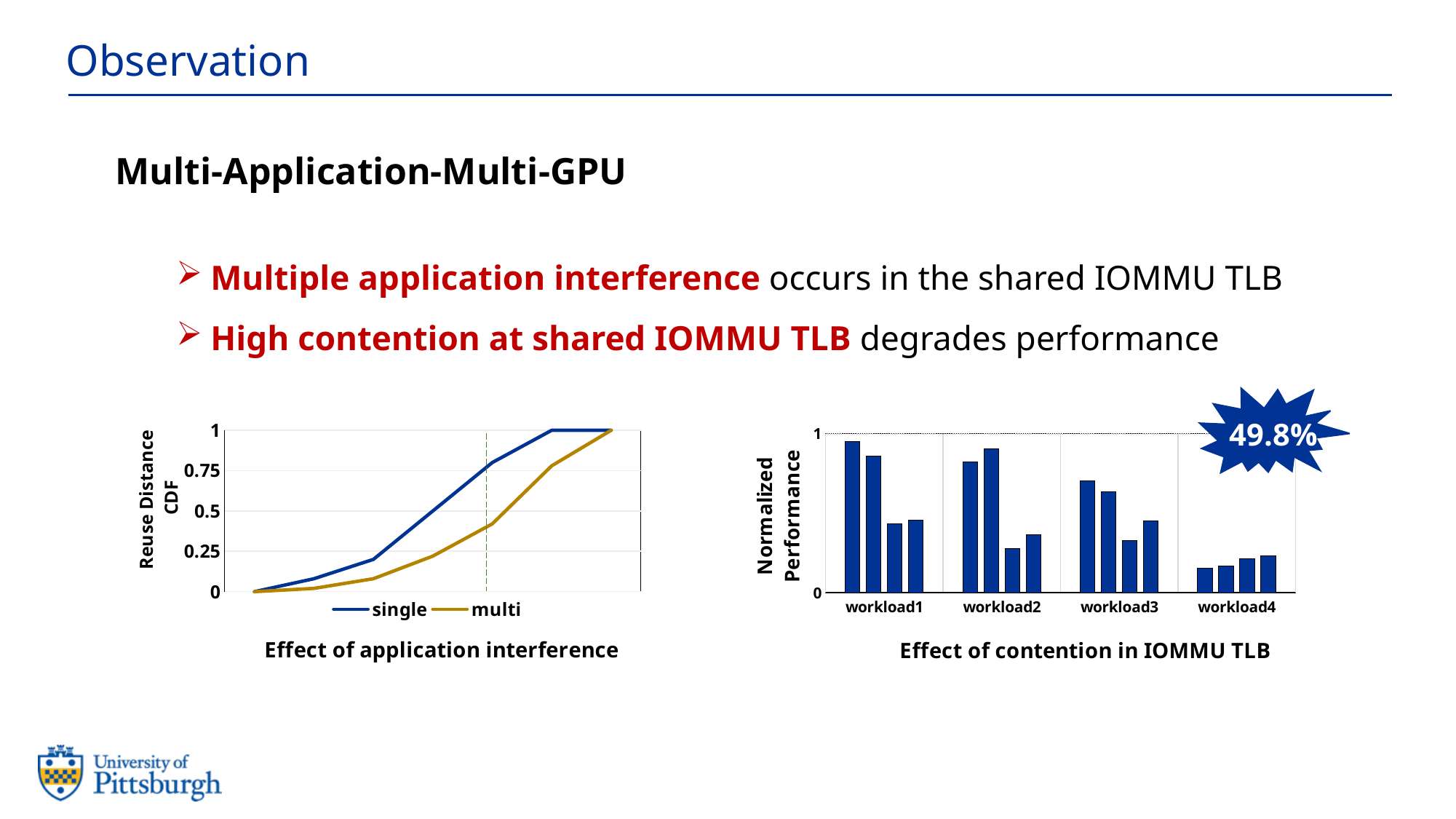
What percentage is shown in the starburst callout next to the 'Effect of contention in IOMMU TLB' chart? 49.8% In the 'Effect of application interference' chart, what is the maximum value shown on the y axis? 1 In the 'Effect of application interference' chart, at the green dashed vertical line, which series has the higher CDF value, single or multi? single What kind of chart is the 'Effect of contention in IOMMU TLB' chart? bar chart What are the two series named in the legend of the 'Effect of application interference' chart? single and multi How many workload categories are shown on the x axis of the 'Effect of contention in IOMMU TLB' chart? 4 How many series does the legend of the 'Effect of application interference' chart list? 2 In the 'Effect of application interference' chart, do the CDF values rise or fall along the x axis? rise In the 'Effect of contention in IOMMU TLB' chart, which is taller: the first bar of workload1 or the first bar of workload4? the first bar of workload1 What kind of chart is the 'Effect of application interference' chart? line chart In the 'Effect of contention in IOMMU TLB' chart, is the first bar of workload1 greater or less than 1? less In the 'Effect of contention in IOMMU TLB' chart, which workload has the lowest normalized performance bars? workload4